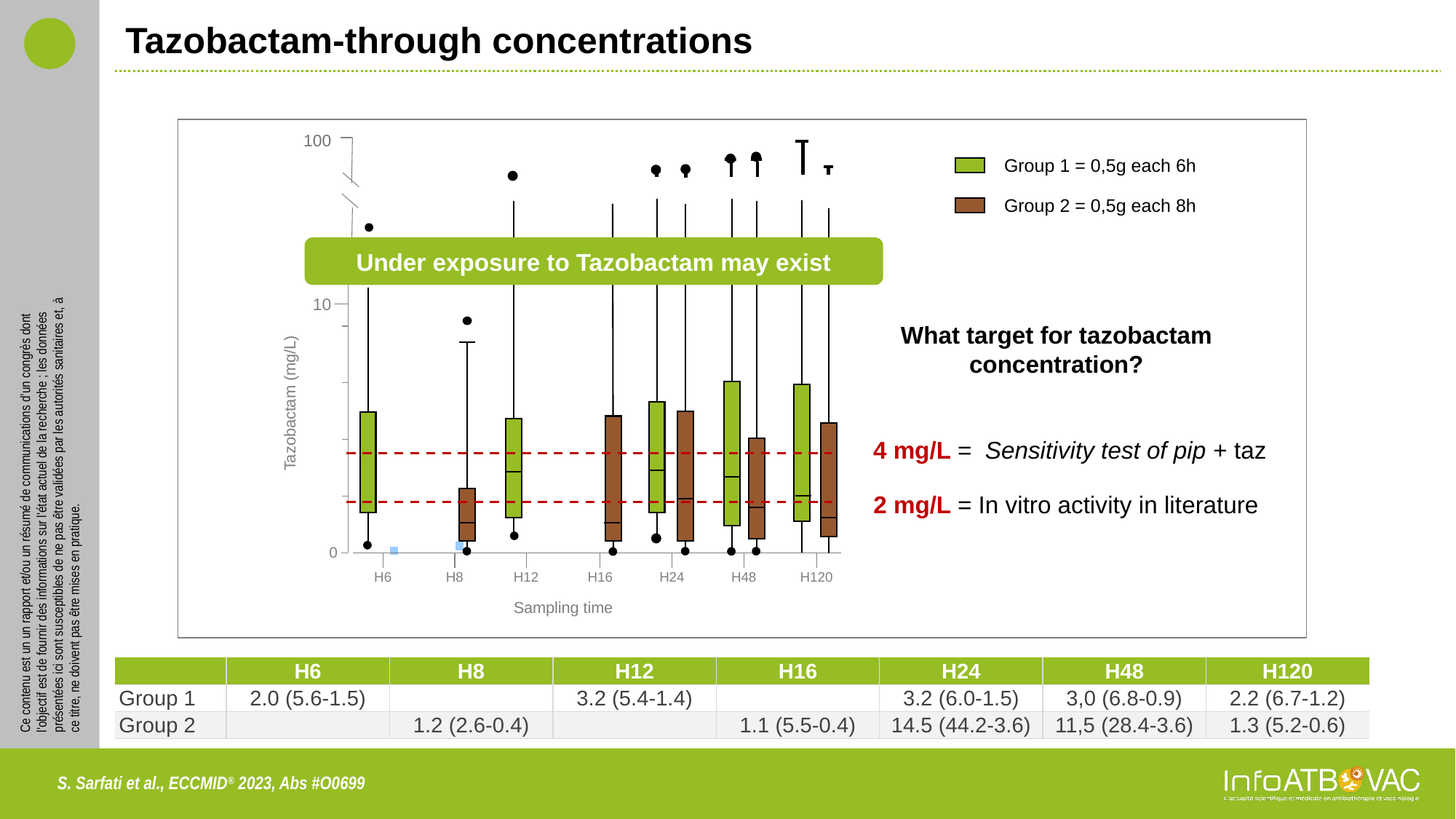
Is the median of the Group 2 box at H8 greater or less than 2 mg/L? less Which group has a box plotted at the H6 sampling time? Group 1 What dosing regimen does the legend give for Group 1? 0,5g each 6h Is the median of the Group 1 box at H12 greater or less than 2 mg/L? greater According to the table, at which sampling time is the Group 2 median highest? H24 According to the table, what is the Group 1 value at H120? 2.2 (6.7-1.2) What kind of chart is shown on the slide? Box plot According to the table, what is the Group 1 value at H6? 2.0 (5.6-1.5) How many sampling times are shown on the x axis of the chart? 7 What is the label of the y axis of the chart? Tazobactam (mg/L) How many groups does the chart legend list? 2 According to the table, what is the Group 2 value at H24? 14.5 (44.2-3.6)